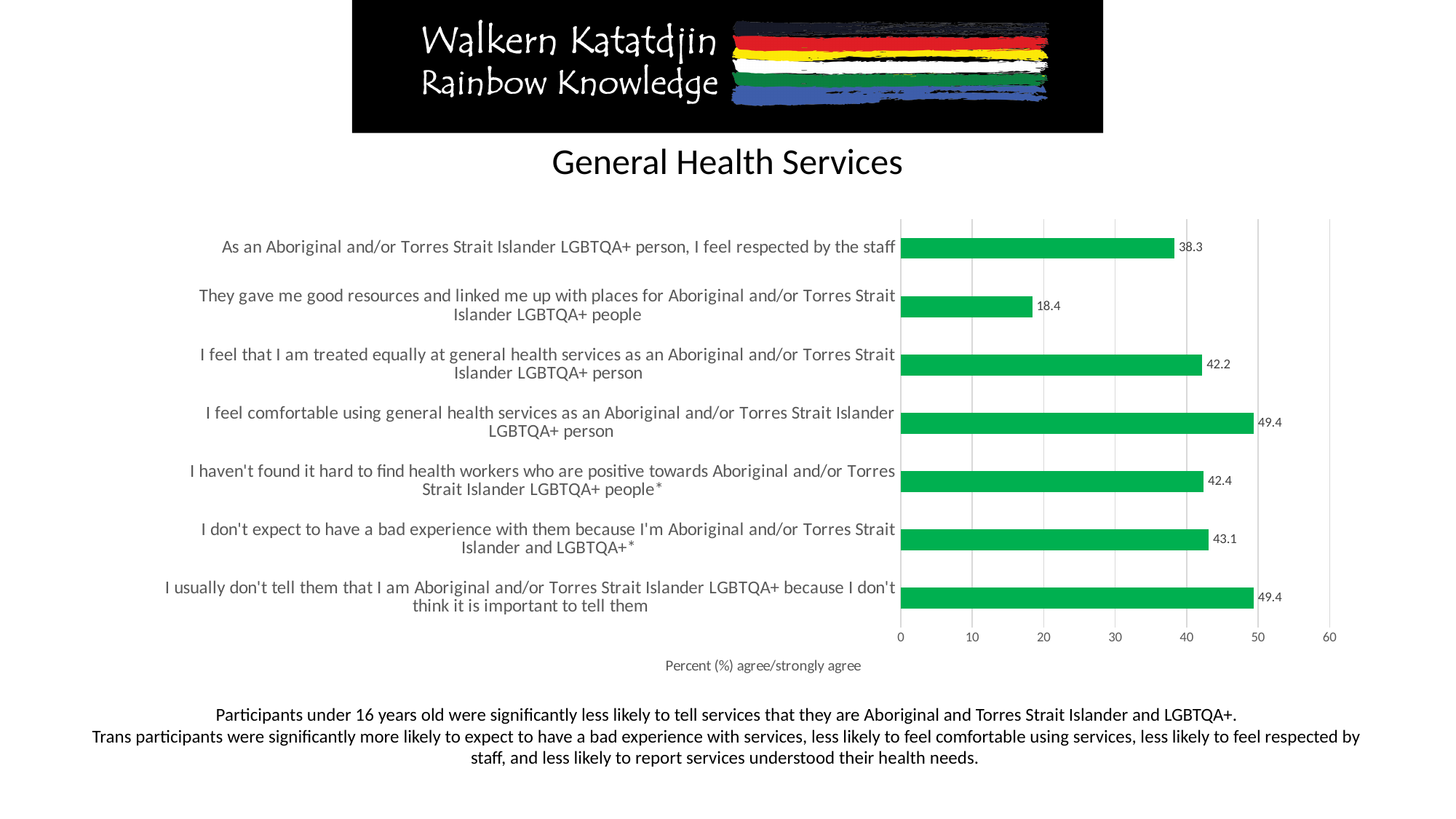
Which is larger: the value for "I don't expect to have a bad experience with them because I'm Aboriginal and/or Torres Strait Islander and LGBTQA+*" or the value for "As an Aboriginal and/or Torres Strait Islander LGBTQA+ person, I feel respected by the staff"? I don't expect to have a bad experience with them because I'm Aboriginal and/or Torres Strait Islander and LGBTQA+* What is the value for "I don't expect to have a bad experience with them because I'm Aboriginal and/or Torres Strait Islander and LGBTQA+*"? 43.1 How many statements (categories) are plotted in the chart? 7 What kind of chart is shown on the slide? bar chart What is the value for "As an Aboriginal and/or Torres Strait Islander LGBTQA+ person, I feel respected by the staff"? 38.3 What is the value for "I feel comfortable using general health services as an Aboriginal and/or Torres Strait Islander LGBTQA+ person"? 49.4 Which statement has the lowest value in the chart? They gave me good resources and linked me up with places for Aboriginal and/or Torres Strait Islander LGBTQA+ people What is the difference between the value for "I feel comfortable using general health services as an Aboriginal and/or Torres Strait Islander LGBTQA+ person" and the value for "They gave me good resources and linked me up with places for Aboriginal and/or Torres Strait Islander LGBTQA+ people"? 31.0 What is the difference between the value for "I feel that I am treated equally at general health services as an Aboriginal and/or Torres Strait Islander LGBTQA+ person" and the value for "As an Aboriginal and/or Torres Strait Islander LGBTQA+ person, I feel respected by the staff"? 3.9 What is the value for "They gave me good resources and linked me up with places for Aboriginal and/or Torres Strait Islander LGBTQA+ people"? 18.4 What is the label on the horizontal axis of the chart? Percent (%) agree/strongly agree Is the value for "They gave me good resources and linked me up with places for Aboriginal and/or Torres Strait Islander LGBTQA+ people" greater or less than 20? less